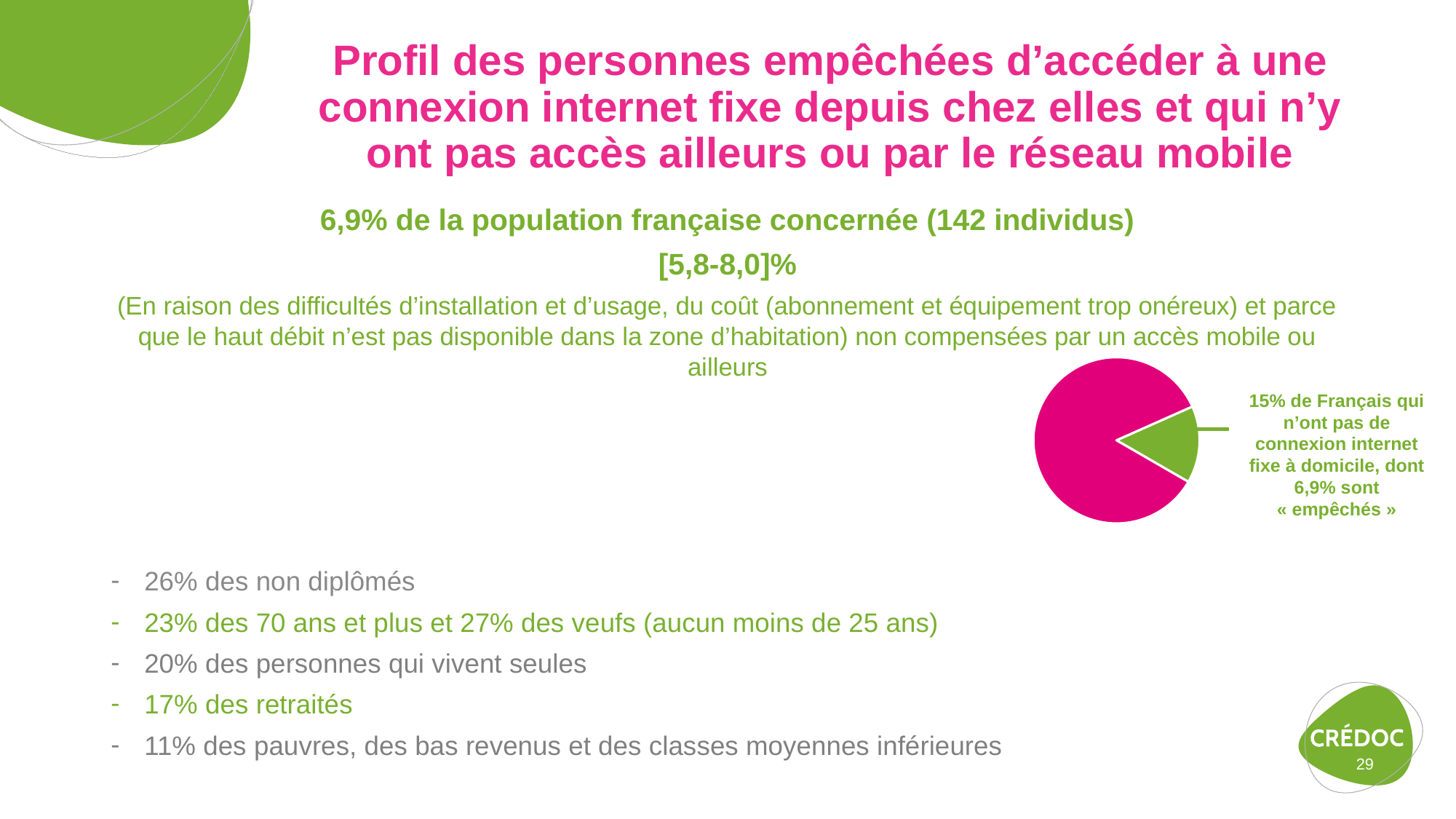
How many slices does the pie chart have? 2 According to the pie chart label, what does the 15% slice represent? Français qui n'ont pas de connexion internet fixe à domicile What colour is the slice labelled 15% in the pie chart? Green Which slice of the pie chart is the smallest? The green slice (15%) What kind of chart is shown on the slide? Pie chart Which slice of the pie chart is larger, the pink one or the green one? The pink one According to the pie chart label, what share of the 15% are « empêchés »? 6,9% What percentage is shown for the green slice of the pie chart? 15%